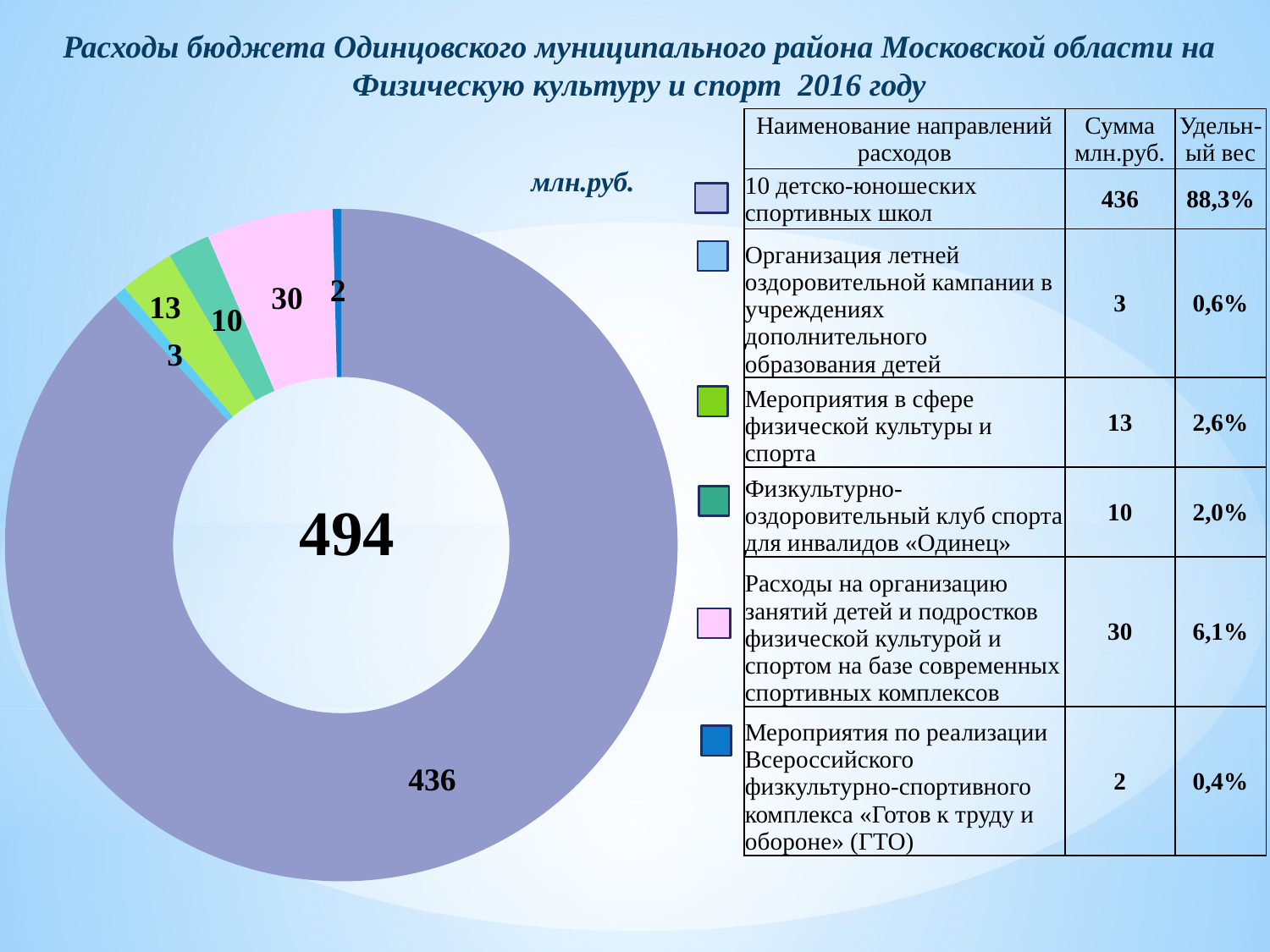
What is the value for «Расходы на организацию занятий детей и подростков физической культурой и спортом на базе современных спортивных комплексов»? 30 What share of the total does «10 детско-юношеских спортивных школ» account for, according to the table? 88,3% What is the total value shown in the centre of the doughnut chart? 494 How many categories (slices) does the chart have? 6 What unit is indicated for the values in the chart? млн.руб. What is the difference between the value for «Расходы на организацию занятий детей и подростков...» (30) and «Мероприятия в сфере физической культуры и спорта» (13)? 17 Which category has the smallest slice in the chart? Мероприятия по реализации Всероссийского физкультурно-спортивного комплекса «Готов к труду и обороне» (ГТО) What kind of chart is shown on the slide? Doughnut (pie) chart What is the value for «Мероприятия в сфере физической культуры и спорта»? 13 Which is larger: the value for «Физкультурно-оздоровительный клуб спорта для инвалидов «Одинец»» or for «Организация летней оздоровительной кампании...»? Физкультурно-оздоровительный клуб спорта для инвалидов «Одинец» Which category has the largest slice in the chart? 10 детско-юношеских спортивных школ What is the value for «10 детско-юношеских спортивных школ» in the chart? 436